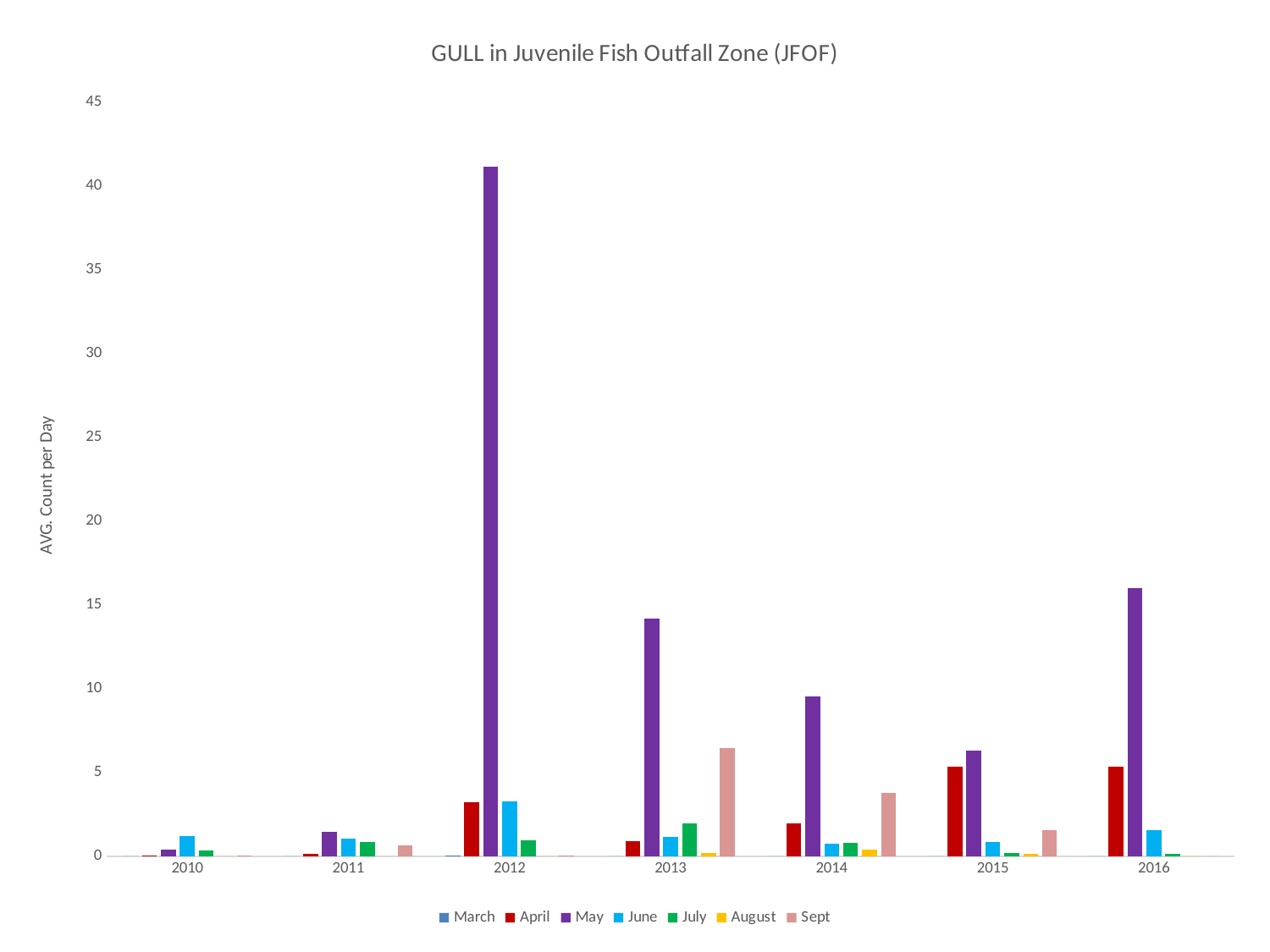
What kind of chart is shown on the slide? bar chart Is the value for May in 2016 greater or less than 15? greater In which year is the May bar the lowest? 2010 Which month has the highest bar in 2013? May How many years are shown along the x axis? 7 How many series does the legend list? 7 Is the value for May in 2012 greater or less than 35? greater Which is larger, the Sept value in 2013 or the Sept value in 2014? 2013 Do the April values rise or fall from 2013 to 2015? rise Is the value for May in 2014 greater or less than 10? less In which year is the May bar the highest? 2012 What is the label on the y axis? AVG. Count per Day